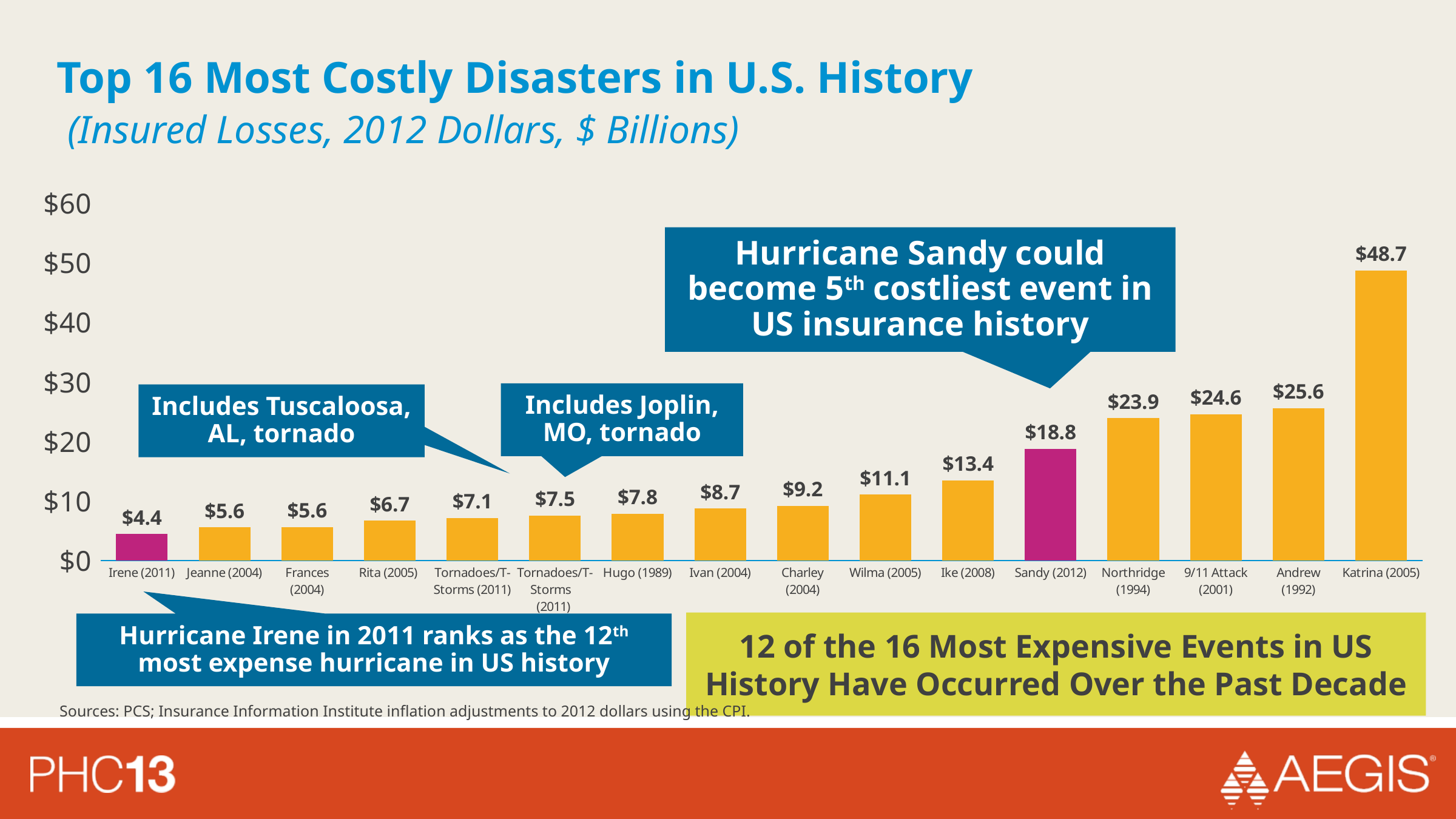
What is the difference between the values for Katrina (2005) and Andrew (1992)? $23.1 Which disaster has the lowest insured loss on the chart? Irene (2011) Which disaster has the highest insured loss on the chart? Katrina (2005) Is the value for 9/11 Attack (2001) greater or less than $20? greater What kind of chart is shown on the slide? Bar chart What is the insured loss value shown for Sandy (2012)? $18.8 What is the insured loss value shown for Irene (2011)? $4.4 How many disasters are plotted on the chart? 16 Which two bars are coloured magenta instead of orange? Irene (2011) and Sandy (2012) What is the insured loss value shown for Northridge (1994)? $23.9 What is the insured loss value shown for Katrina (2005)? $48.7 Which has a larger insured loss, Ike (2008) or Wilma (2005)? Ike (2008)